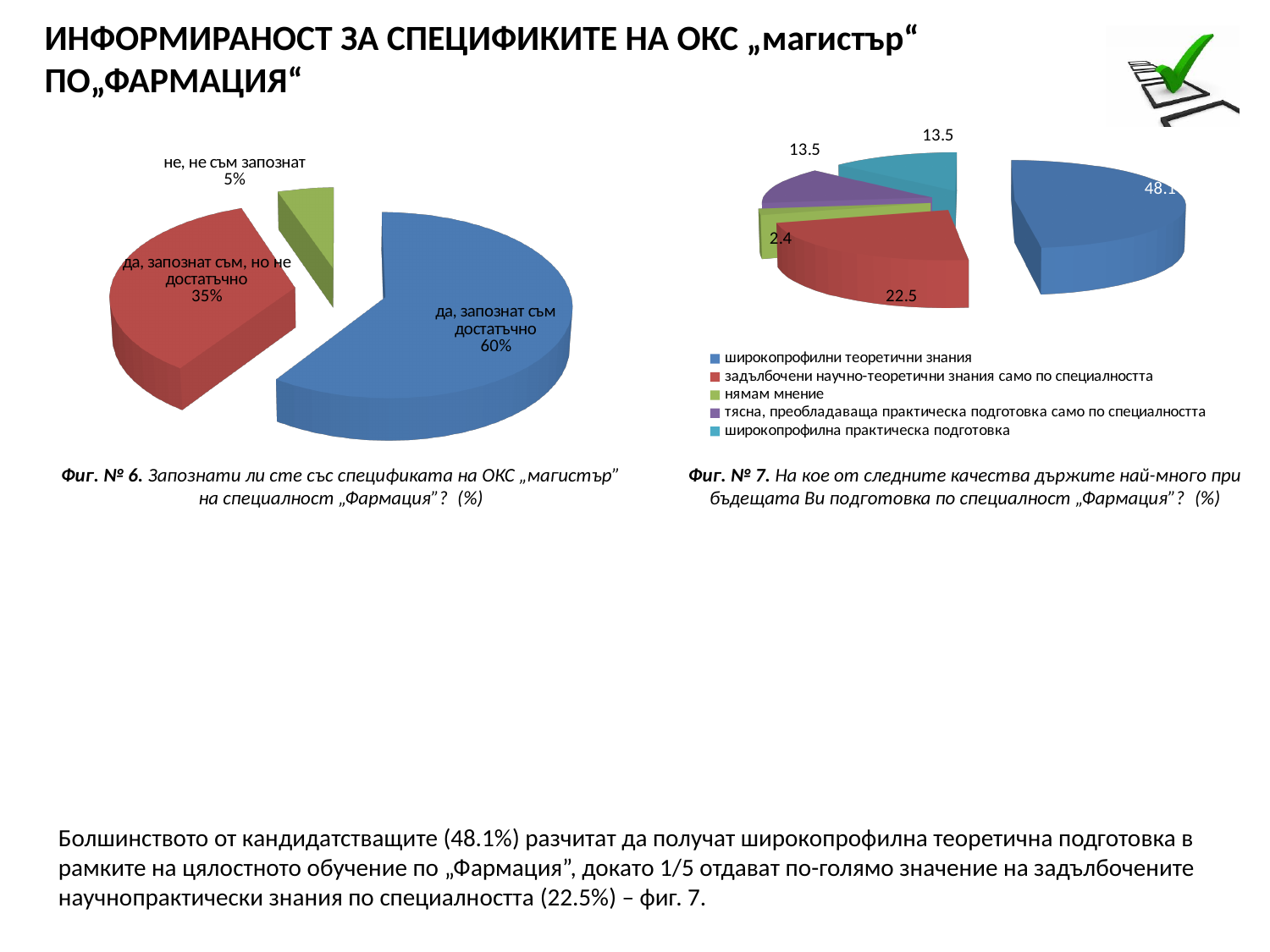
On the left chart (Фиг. № 6), what share of respondents answered "не, не съм запознат"? 5% On the right chart (Фиг. № 7), what is the value for "нямам мнение"? 2.4 On the right chart (Фиг. № 7), what is the value for "задълбочени научно-теоретични знания само по специалността"? 22.5 On the right chart (Фиг. № 7), which is larger: "широкопрофилни теоретични знания" or "задълбочени научно-теоретични знания само по специалността"? широкопрофилни теоретични знания On the right chart (Фиг. № 7), which category has the smallest slice? нямам мнение On the right chart (Фиг. № 7), what colour is the slice for "широкопрофилна практическа подготовка"? Teal (light blue) On the left chart (Фиг. № 6), which answer has the largest slice? да, запознат съм достатъчно On the right chart (Фиг. № 7), how many categories does the legend list? 5 On the left chart (Фиг. № 6), what share of respondents answered "да, запознат съм достатъчно"? 60% What type of chart is shown on the left (Фиг. № 6)? Pie chart On the left chart (Фиг. № 6), how many slices does the pie have? 3 On the left chart (Фиг. № 6), what is the difference between the shares for "да, запознат съм достатъчно" and "да, запознат съм, но не достатъчно"? 25%